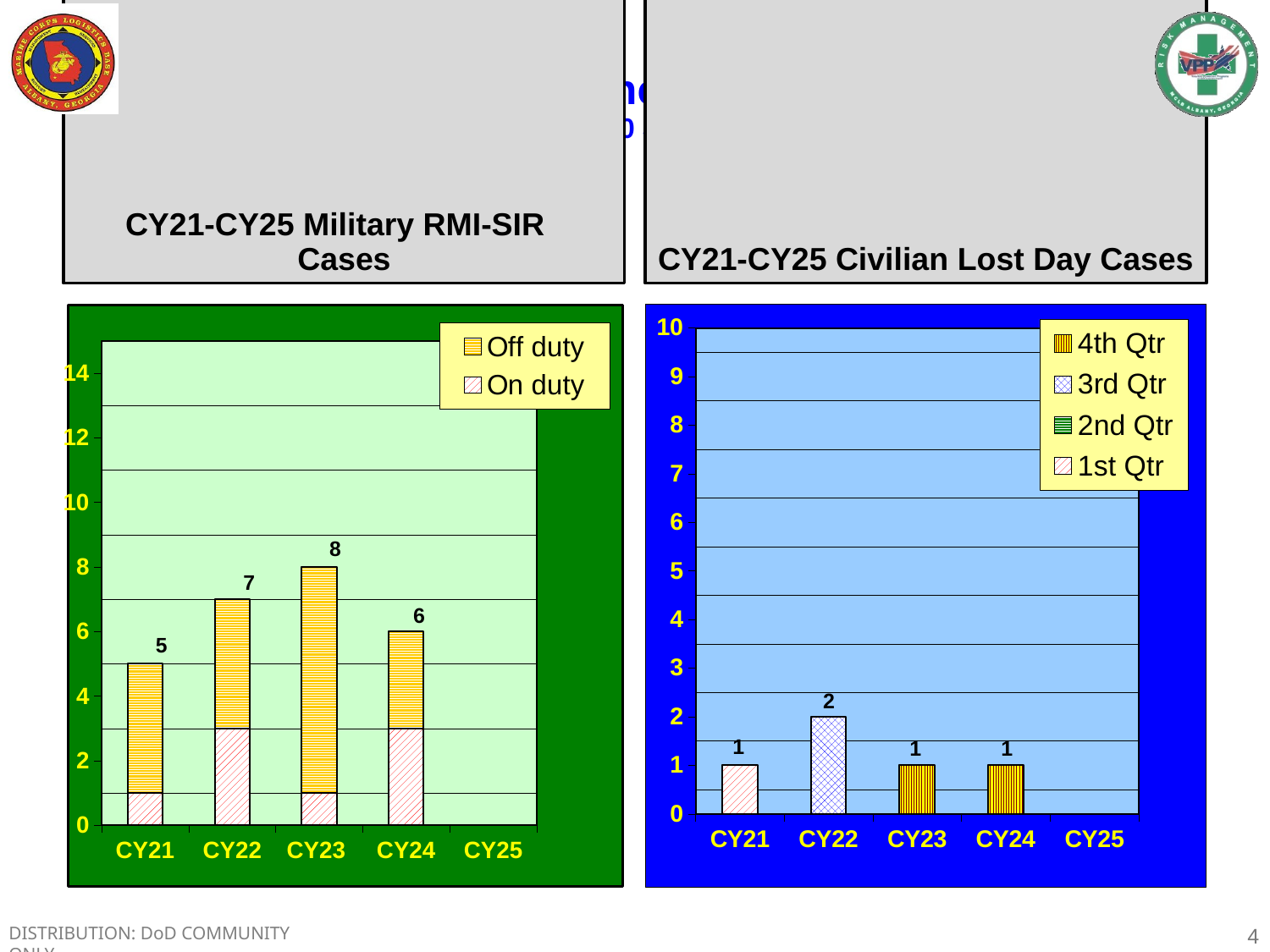
What kind of chart is the CY21-CY25 Civilian Lost Day Cases chart? bar chart In the CY21-CY25 Military RMI-SIR Cases chart, which has the larger total, CY22 or CY24? CY22 In the CY21-CY25 Military RMI-SIR Cases chart, what is the total number of cases for CY23? 8 How many series does the legend of the CY21-CY25 Civilian Lost Day Cases chart list? 4 In the CY21-CY25 Military RMI-SIR Cases chart, which year has the highest total? CY23 In the CY21-CY25 Military RMI-SIR Cases chart, which of CY21 through CY24 has the lowest total? CY21 How many year categories are shown on the x axis of the CY21-CY25 Civilian Lost Day Cases chart? 5 In the CY21-CY25 Military RMI-SIR Cases chart, what is the difference between the totals for CY23 and CY21? 3 In the CY21-CY25 Civilian Lost Day Cases chart, which year has the highest value? CY22 In the CY21-CY25 Military RMI-SIR Cases chart, is the On duty value for CY22 greater or less than 4? less In the CY21-CY25 Civilian Lost Day Cases chart, what is the value for CY22? 2 How many series does the legend of the CY21-CY25 Military RMI-SIR Cases chart list? 2